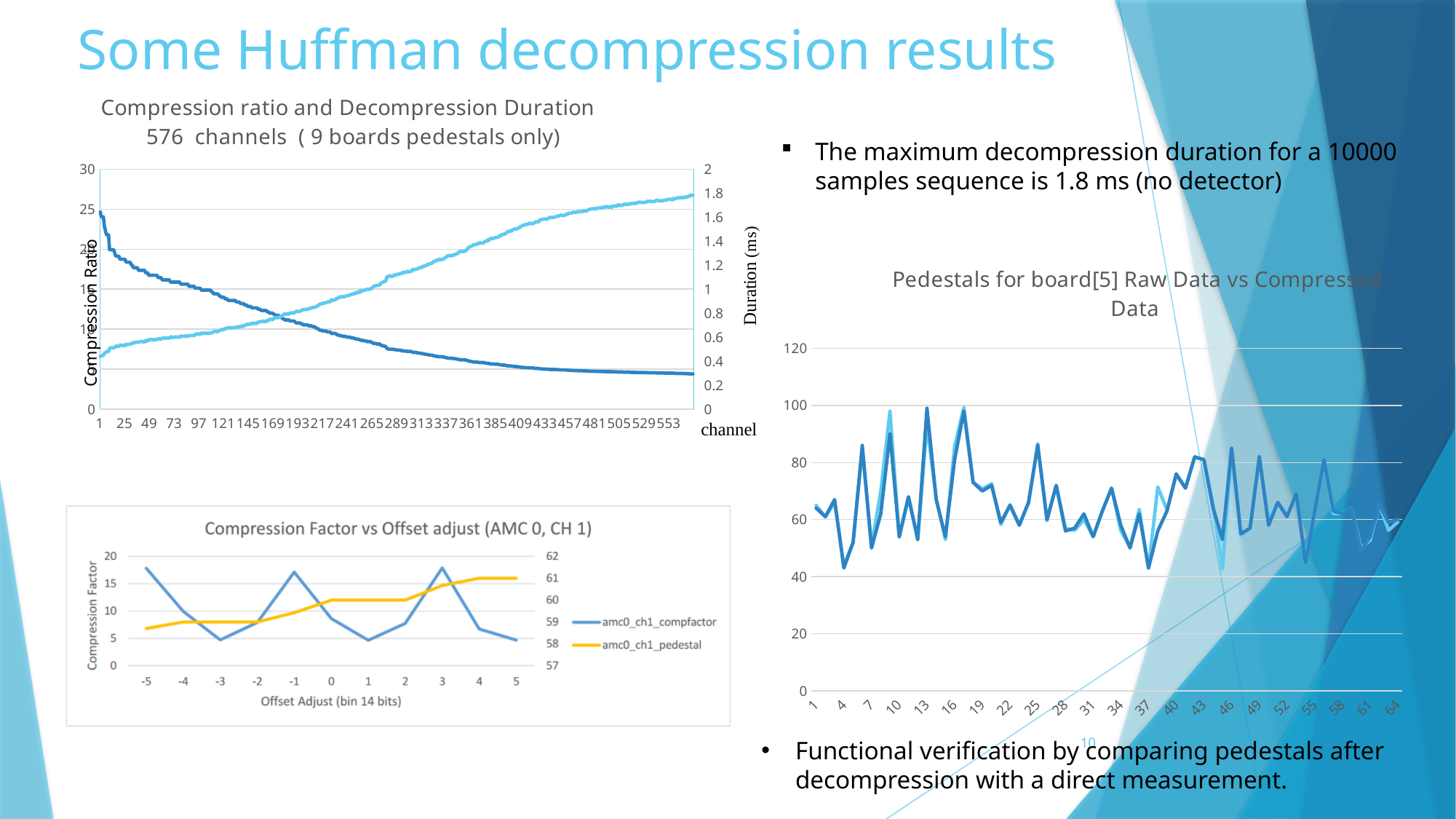
What kind of chart is the 'Compression ratio and Decompression Duration' chart? line chart In the 'Compression ratio and Decompression Duration' chart, does the decompression duration rise or fall as the channel number increases? rise In the 'Pedestals for board[5] Raw Data vs Compressed Data' chart, is the value at x = 13 greater or less than 80? greater In the 'Compression Factor vs Offset adjust (AMC 0, CH 1)' chart, is the amc0_ch1_compfactor value at offset -5 greater or less than 15? greater In the 'Compression ratio and Decompression Duration' chart, does the compression ratio rise or fall as the channel number increases? fall In the 'Compression ratio and Decompression Duration' chart, is the compression ratio at channel 1 greater or less than 20? greater How many series does the legend of the 'Compression Factor vs Offset adjust (AMC 0, CH 1)' chart list? 2 In the 'Compression Factor vs Offset adjust (AMC 0, CH 1)' chart, does the amc0_ch1_pedestal series rise or fall as the offset adjust increases? rise In the 'Compression ratio and Decompression Duration' chart, what is the label of the right-hand vertical axis? Duration (ms) In the 'Compression Factor vs Offset adjust (AMC 0, CH 1)' chart, how many offset adjust values are plotted on the x axis? 11 In the 'Compression Factor vs Offset adjust (AMC 0, CH 1)' chart, which is larger, the amc0_ch1_compfactor value at offset -5 or at offset -3? offset -5